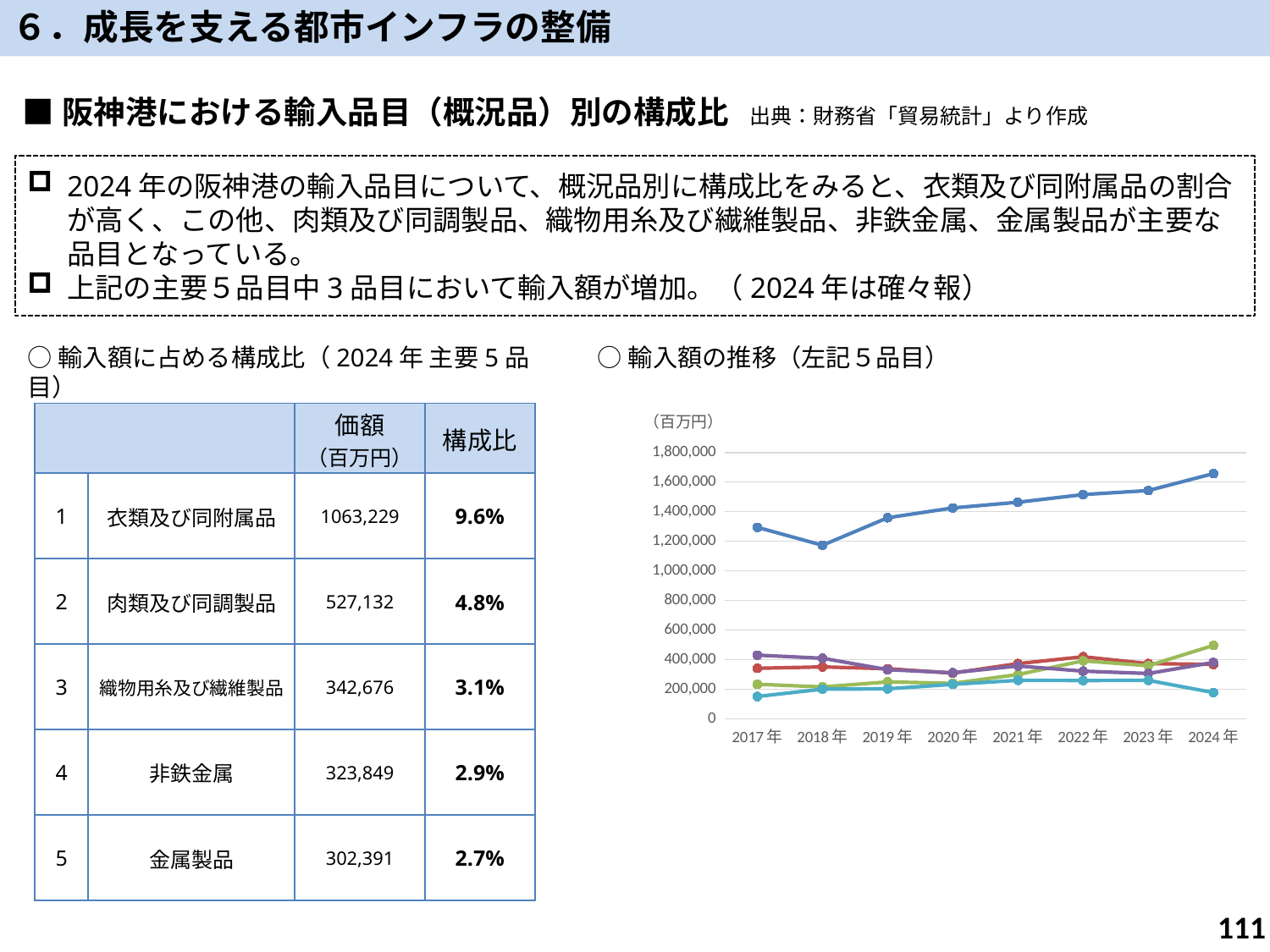
What kind of chart is shown under the heading 輸入額の推移（左記5品目）? line chart How many lines are plotted in the 輸入額の推移 line chart? 5 What unit is shown above the y axis of the 輸入額の推移 line chart? 百万円 In the 輸入額の推移 line chart, is the value of the top (blue) line in 2017年 greater or less than 1,200,000? greater In the 輸入額の推移 line chart, in which year does the highest (blue) line reach its highest point? 2024年 In the 輸入額の推移 line chart, is the lowest line's value in 2017年 greater or less than 200,000? less In the 輸入額の推移 line chart, is the value of the top (blue) line in 2024年 greater or less than 1,600,000? greater In the 輸入額の推移 line chart, in which year does the highest (blue) line reach its lowest point? 2018年 In the 輸入額の推移 line chart, does the top (blue) line rise or fall from 2018年 to 2024年? rise What is the highest tick value shown on the y axis of the 輸入額の推移 line chart? 1,800,000 How many years are shown on the x axis of the 輸入額の推移 line chart? 8